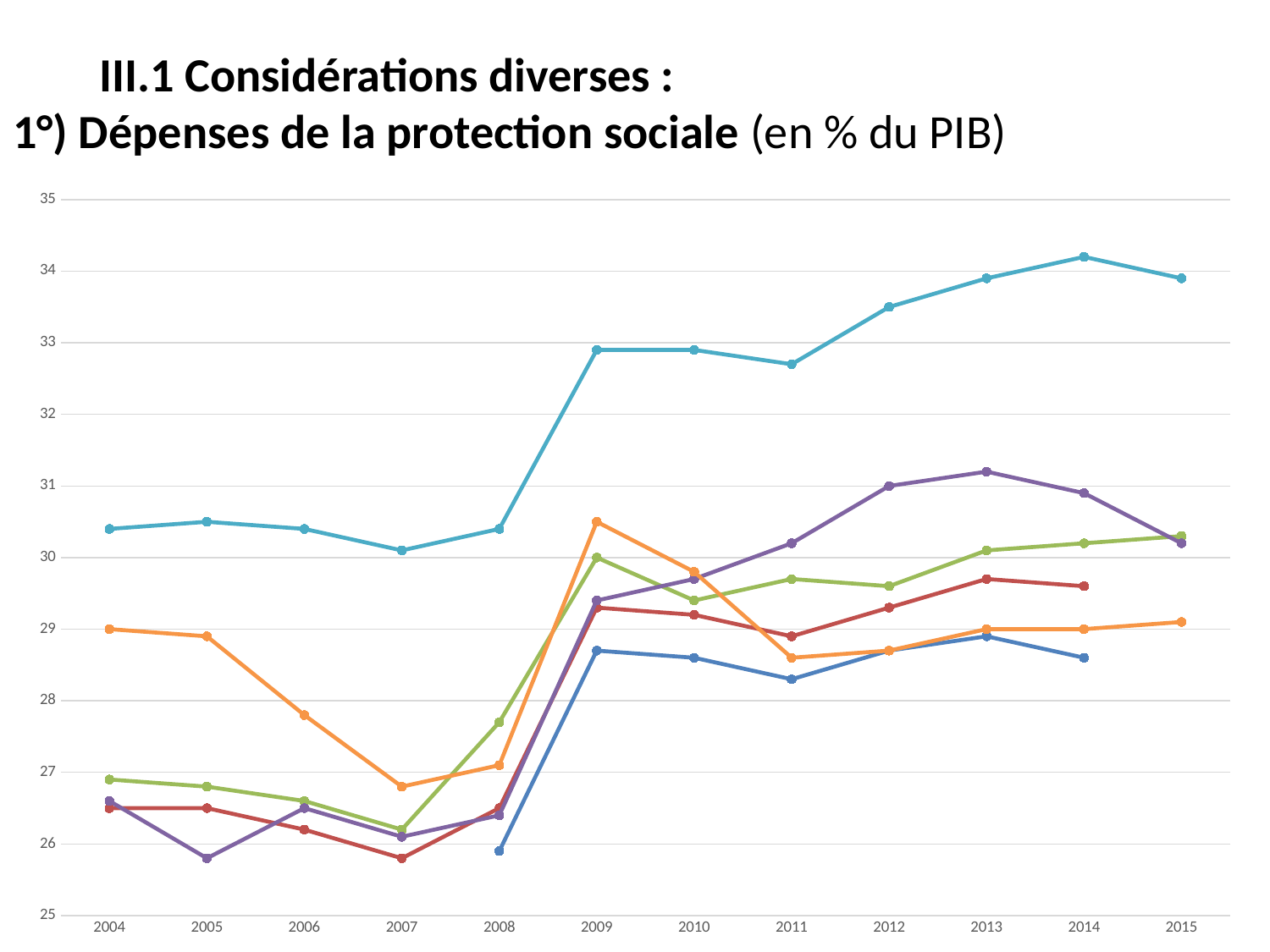
Does the light blue line rise or fall between 2011 and 2014? rise What kind of chart is shown on the slide? line chart Does the orange line rise or fall between 2004 and 2007? fall How many years are shown along the x axis of the chart? 12 Is the value of the orange line in 2007 greater or less than 27? less Is the value of the light blue line in 2009 greater or less than 32? greater In 2009, which is larger: the value of the light blue line or the value of the orange line? the light blue line What is the first year shown on the x axis of the chart? 2004 What is the last year shown on the x axis of the chart? 2015 Which coloured line has the highest value in 2015? the light blue line Is the value of the dark blue line in 2008 greater or less than 26? less